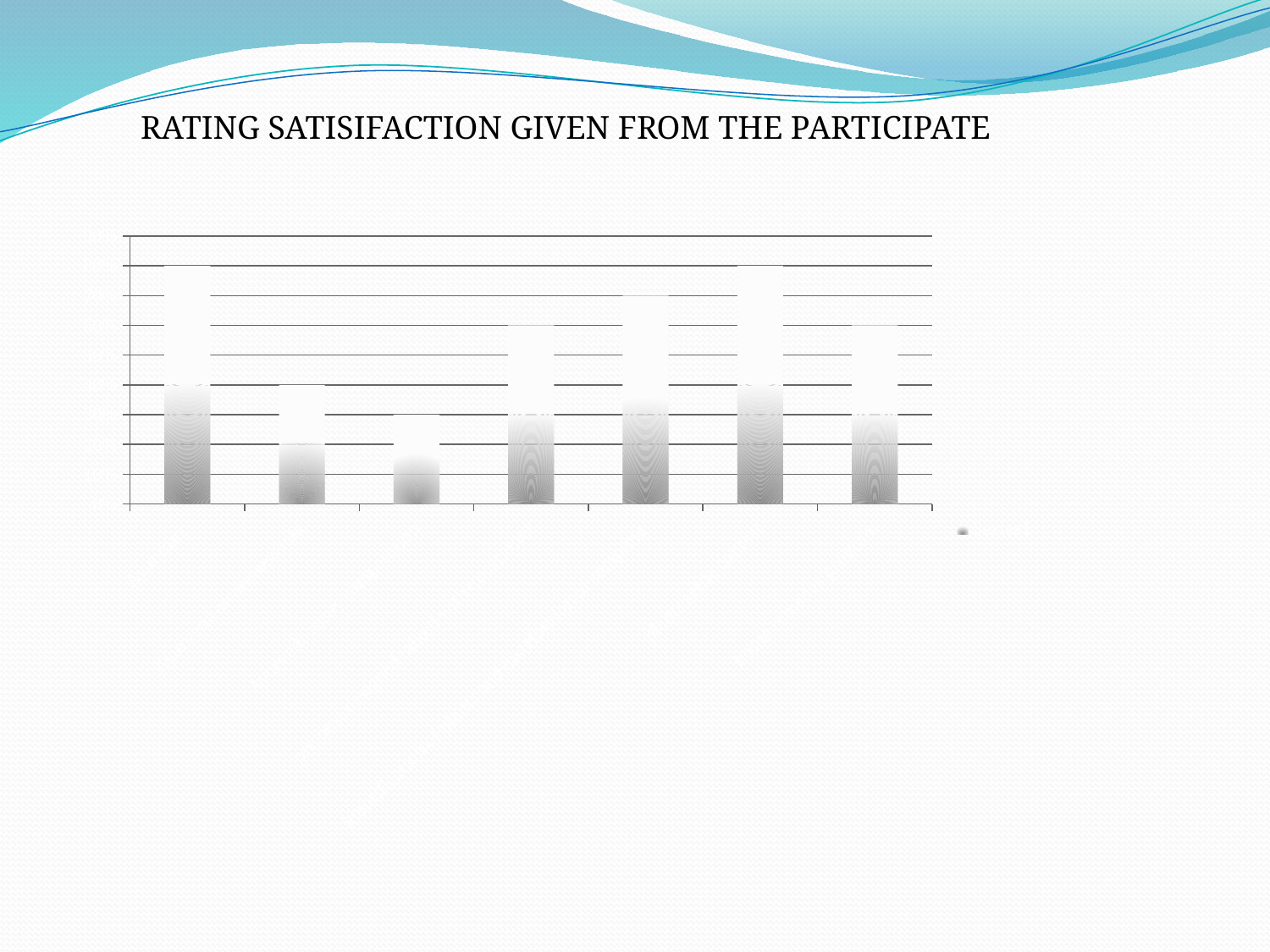
Counting from the left, which bar is the shortest in the chart? the third bar Which is taller, the fifth bar from the left or the seventh bar from the left? the fifth bar Are the bars in the chart vertical or horizontal? vertical Which is taller, the first bar from the left or the second bar from the left? the first bar What kind of chart is shown on the slide? bar chart How many bars are plotted in the chart? 7 Counting from the left, which bar is the tallest in the chart? the first and sixth bars (tied) What is the title text shown above the chart on the slide? RATING SATISIFACTION GIVEN FROM THE PARTICIPATE